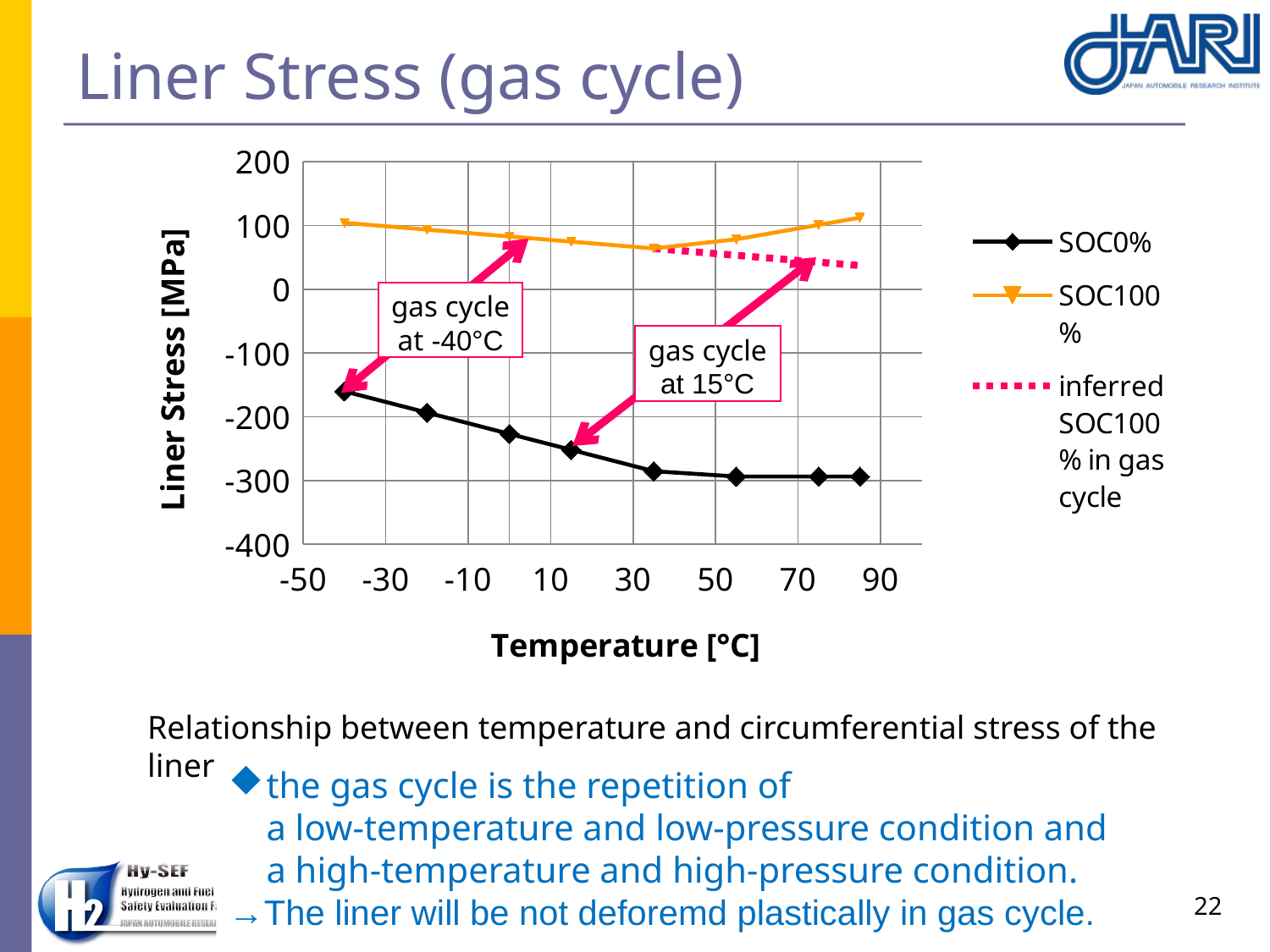
At which temperature is the SOC0% liner stress highest? -40°C Does the SOC0% liner stress rise or fall as temperature increases? fall Is the SOC0% liner stress at 85°C greater or less than -200 MPa? less How many series does the legend list? 3 What kind of chart is shown on the slide? line chart What is the label of the y axis? Liner Stress [MPa] Is the SOC100% liner stress at -40°C greater or less than 0 MPa? greater Is the SOC0% liner stress at -40°C greater or less than -200 MPa? greater What is the label of the x axis? Temperature [°C] Which series has the higher liner stress at 15°C, SOC0% or SOC100%? SOC100%